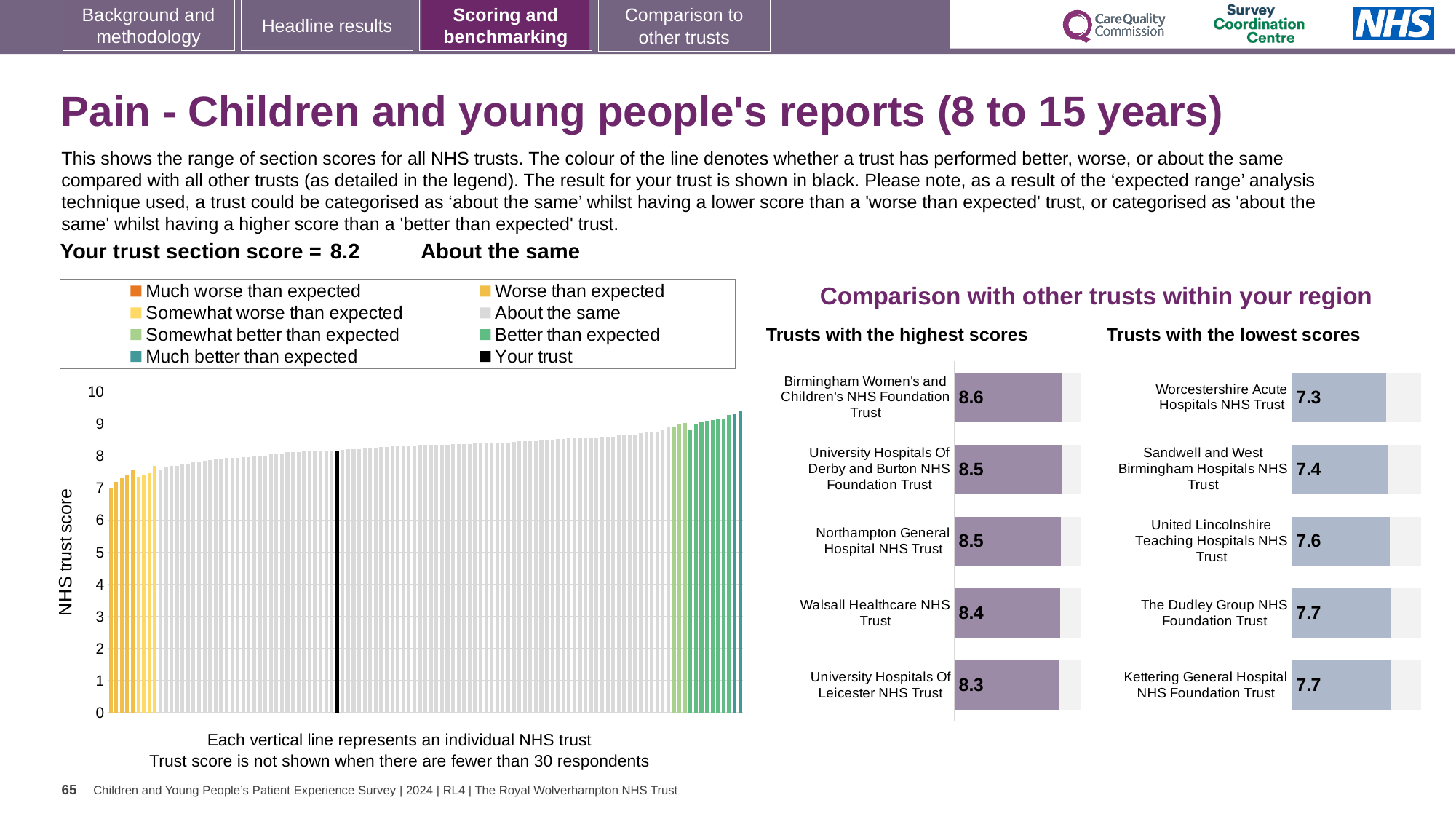
In the main chart on the left showing all NHS trusts, is the value for the black bar (your trust) greater or less than 8? greater In the 'Trusts with the highest scores' chart, which has the higher score: Walsall Healthcare NHS Trust or University Hospitals Of Leicester NHS Trust? Walsall Healthcare NHS Trust In the main chart on the left showing all NHS trusts, do the values rise or fall from left to right? rise In the 'Trusts with the highest scores' chart, which trust has the highest score? Birmingham Women's and Children's NHS Foundation Trust In the 'Trusts with the highest scores' chart, what is the difference between the scores of Birmingham Women's and Children's NHS Foundation Trust and University Hospitals Of Leicester NHS Trust? 0.3 How many trusts are shown in the 'Trusts with the lowest scores' chart? 5 In the 'Trusts with the lowest scores' chart, what is the difference between the scores of The Dudley Group NHS Foundation Trust and Worcestershire Acute Hospitals NHS Trust? 0.4 How many entries does the legend of the main chart on the left list? 8 In the 'Trusts with the highest scores' chart, what is the score for Birmingham Women's and Children's NHS Foundation Trust? 8.6 In the 'Trusts with the lowest scores' chart, which trust has the lowest score? Worcestershire Acute Hospitals NHS Trust In the 'Trusts with the lowest scores' chart, what is the score for Kettering General Hospital NHS Foundation Trust? 7.7 In the 'Trusts with the lowest scores' chart, what is the score for Worcestershire Acute Hospitals NHS Trust? 7.3